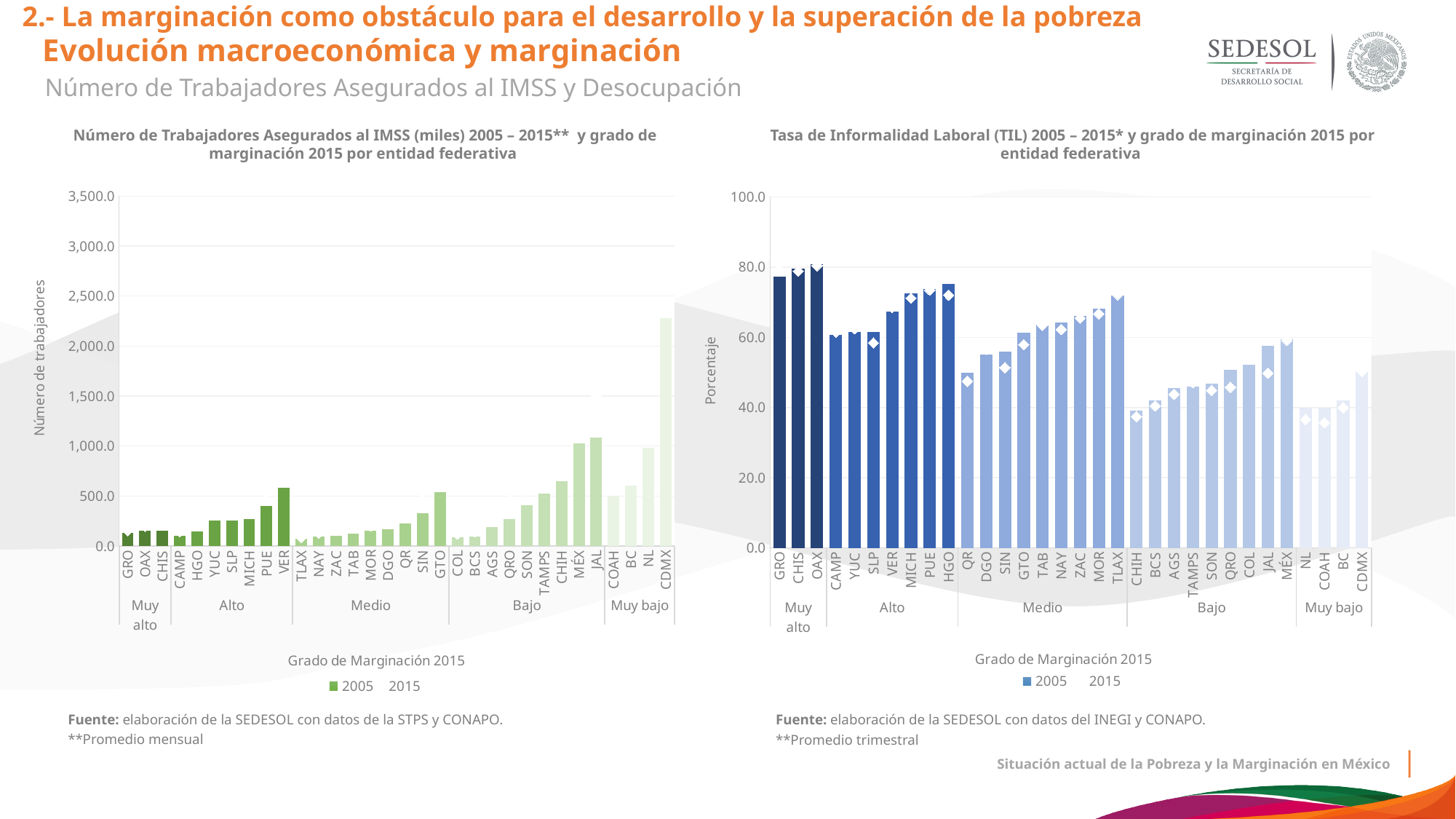
In the right chart (Tasa de Informalidad Laboral), is the value for NL greater or less than 60.0? less In the left chart (Número de Trabajadores Asegurados al IMSS), is the value for VER greater or less than 500.0? greater In the right chart (Tasa de Informalidad Laboral), what kind of chart is it? Bar chart In the left chart (Número de Trabajadores Asegurados al IMSS), is the value for CDMX greater or less than 2,000.0? greater In the left chart (Número de Trabajadores Asegurados al IMSS), which is larger, the value for JAL or the value for VER? JAL In the left chart (Número de Trabajadores Asegurados al IMSS), what is the label of the vertical axis? Número de trabajadores In the left chart (Número de Trabajadores Asegurados al IMSS), which state has the highest number of insured workers? CDMX In the right chart (Tasa de Informalidad Laboral), which is larger, the value for OAX or the value for CDMX? OAX In the left chart (Número de Trabajadores Asegurados al IMSS), how many series does the legend list? 2 In the right chart (Tasa de Informalidad Laboral), how many marginalization groups are shown along the x axis? 5 In the right chart (Tasa de Informalidad Laboral), what is the title of the horizontal axis? Grado de Marginación 2015